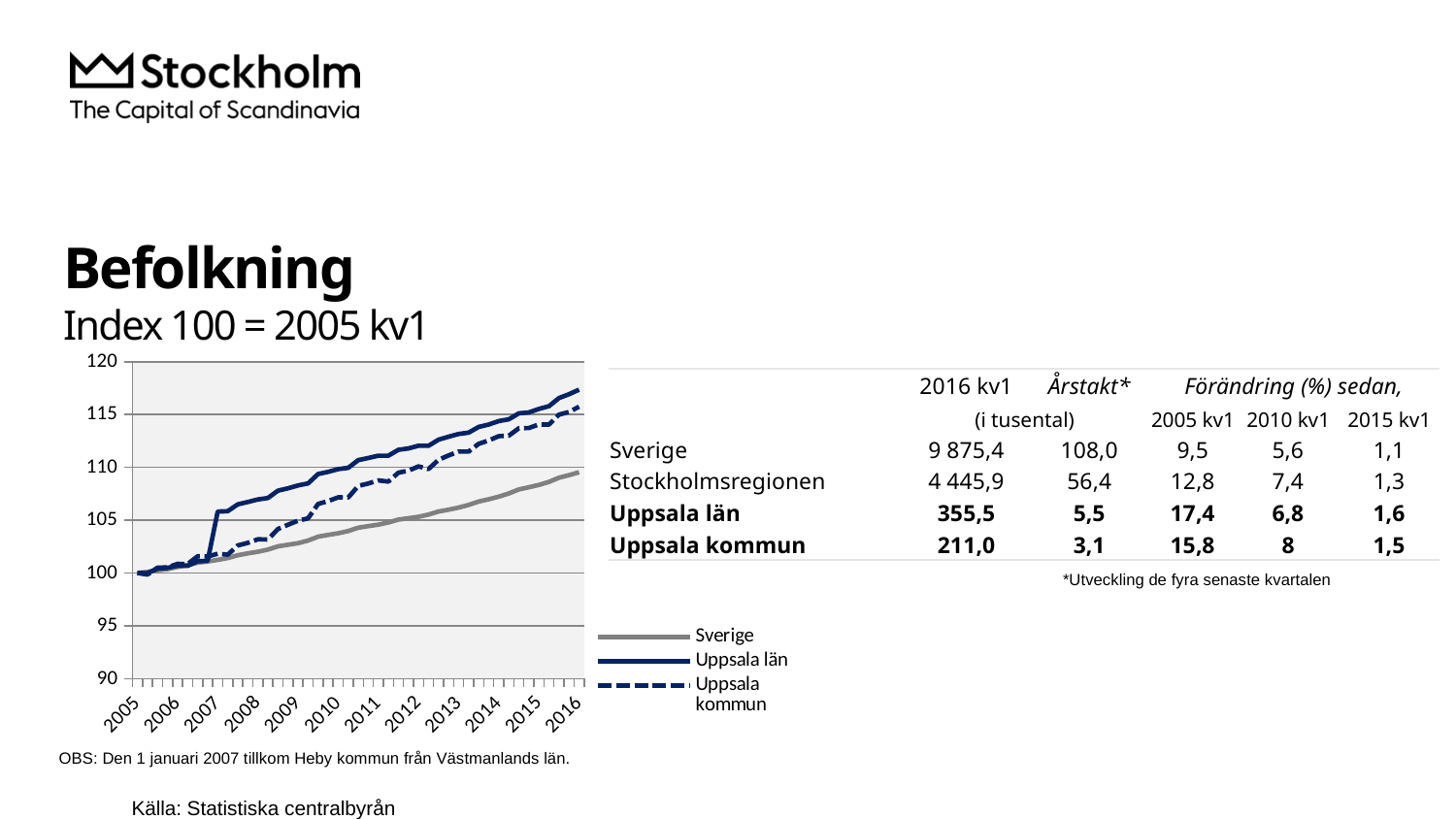
What type of chart is shown on the slide? line chart Which series in the chart is drawn with a dashed line? Uppsala kommun At 2016, is the index for Uppsala län or for Sverige higher? Uppsala län Which series are listed in the chart's legend? Sverige, Uppsala län, Uppsala kommun How many series does the chart's legend list? 3 Which series has the lowest index value at the end of the chart in 2016? Sverige Which series has the highest index value at the end of the chart in 2016? Uppsala län Do the index values in the chart rise or fall from 2005 to 2016? rise Is the index value for Uppsala län in 2016 greater or less than 115? greater Is the index value for Sverige in 2010 greater or less than 105? less How many year labels are shown on the chart's x axis? 12 What index value do all three series start at in 2005 kv1? 100